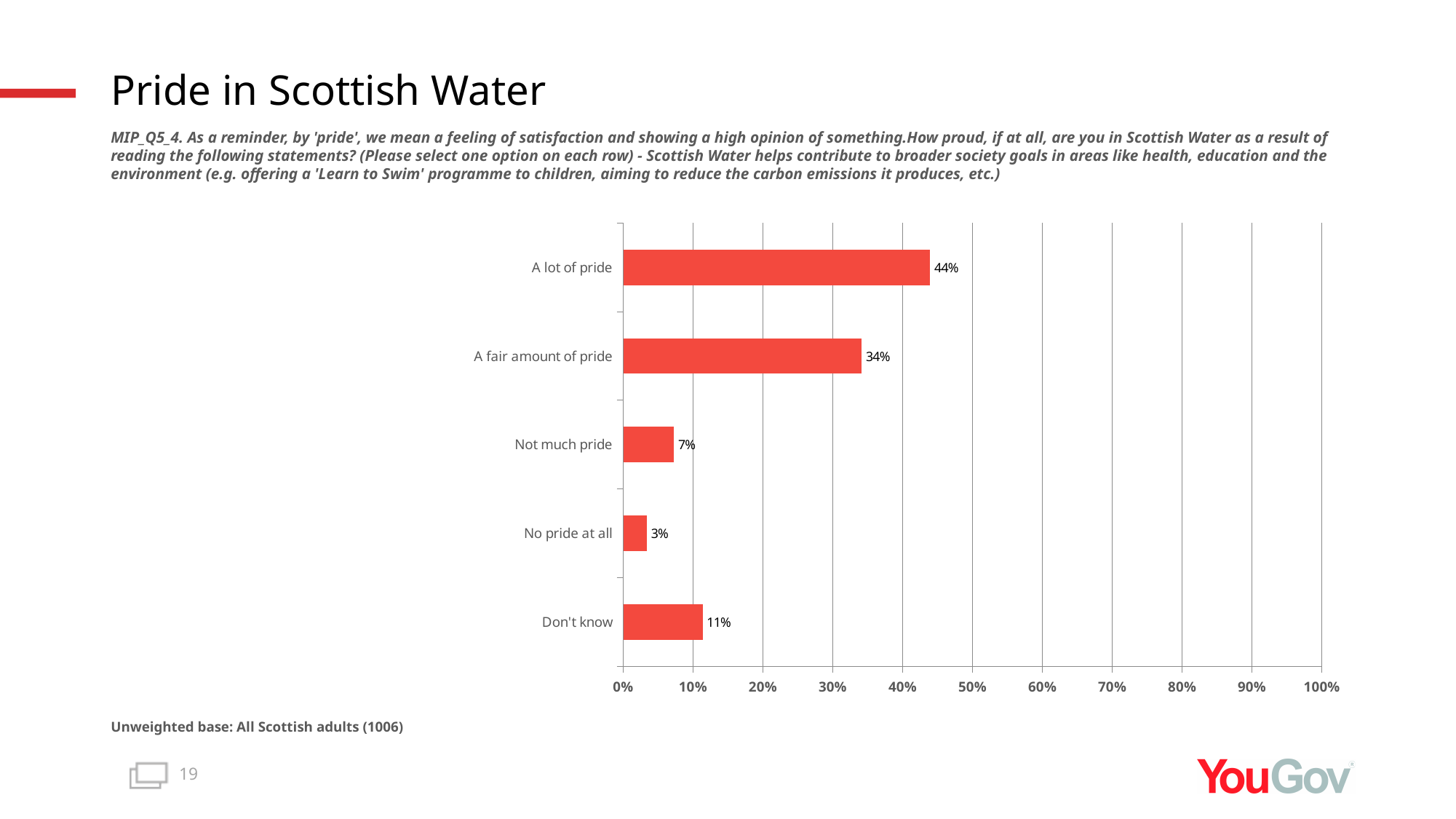
How many response categories are shown in the chart? 5 What is the value shown for 'A fair amount of pride'? 34% What is the difference between 'A lot of pride' and 'A fair amount of pride'? 10 percentage points Which response category has the lowest value? No pride at all What percentage of respondents answered 'Don't know'? 11% What is the value for 'No pride at all'? 3% What kind of chart is shown on the slide? Bar chart Which is larger, 'Not much pride' or 'Don't know'? Don't know What percentage of respondents said they feel 'A lot of pride'? 44% What is the combined value of 'Not much pride' and 'No pride at all'? 10% Which response category has the highest value? A lot of pride Is the value for 'A lot of pride' greater or less than 40%? greater